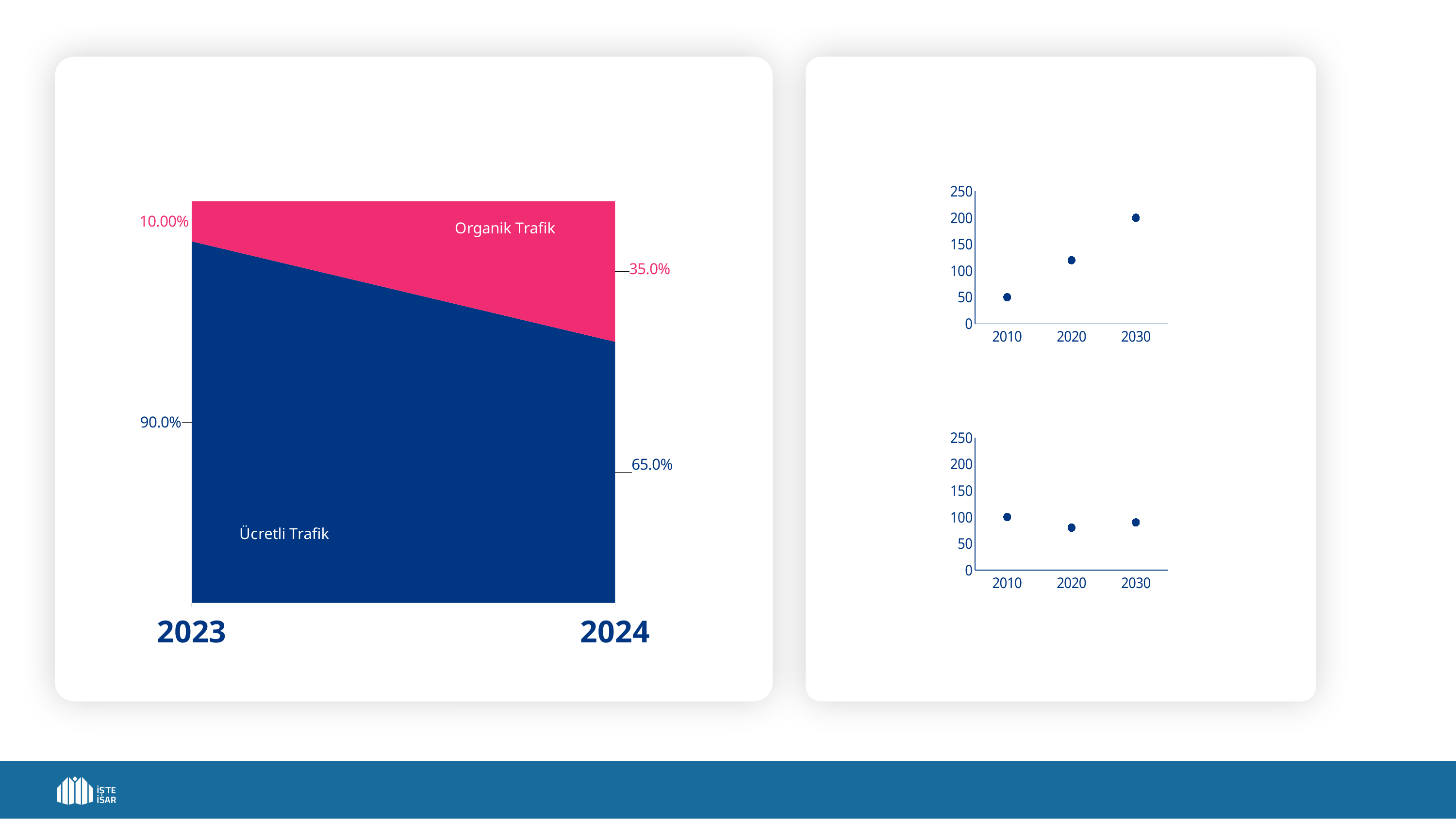
In the top-right dot chart, is the value for 2020 greater or less than 100? greater In the bottom-right dot chart, which year has the highest value? 2010 In the left area chart, what is the value for Organik Trafik in 2024? 35.0% In the top-right dot chart, which year has the highest value? 2030 In the left area chart, does the share of Organik Trafik rise or fall from 2023 to 2024? rise In the left area chart, what is the value for Organik Trafik in 2023? 10.00% In the left area chart, what is the value for Ücretli Trafik in 2023? 90.0% In the left area chart, what is the difference between the Ücretli Trafik values for 2023 and 2024? 25 percentage points In the left area chart, which series is shown in pink? Organik Trafik In the left area chart, what is the value for Ücretli Trafik in 2024? 65.0% How many data points are plotted in the bottom-right dot chart? 3 In the left area chart, which series is larger in 2024, Organik Trafik or Ücretli Trafik? Ücretli Trafik